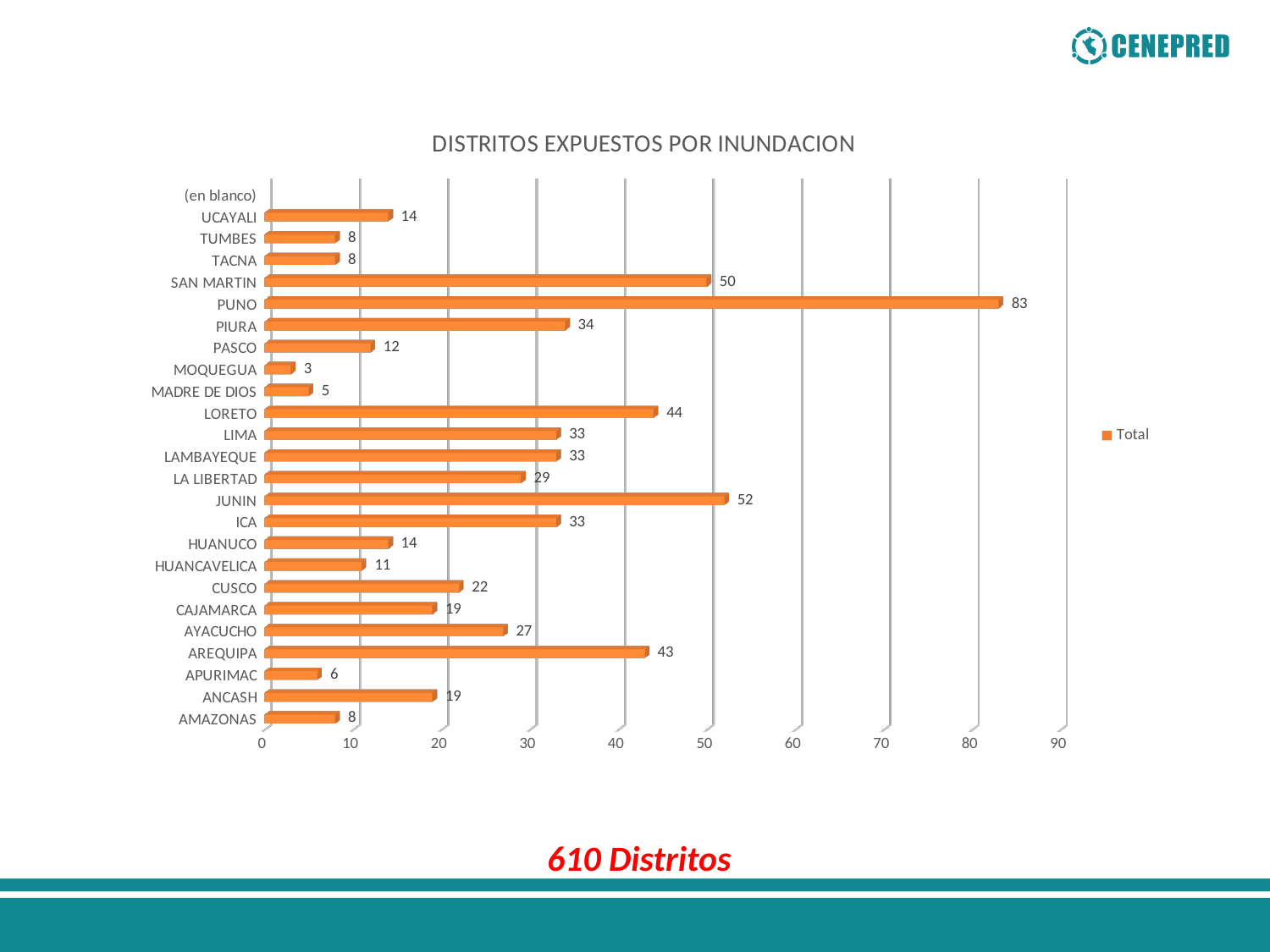
Which category with a bar has the lowest value? MOQUEGUA How many categories have a value of 33? 3 What is the value for PUNO? 83 Is the value for PUNO greater or less than 80? greater What is the difference between the values for SAN MARTIN and PIURA? 16 Which category has the highest value? PUNO What kind of chart is shown on the slide? bar chart What is the difference between the values for PUNO and JUNIN? 31 How many series does the legend list? 1 What is the value for MADRE DE DIOS? 5 Which is larger, the value for JUNIN or the value for SAN MARTIN? JUNIN What is the value for LA LIBERTAD? 29